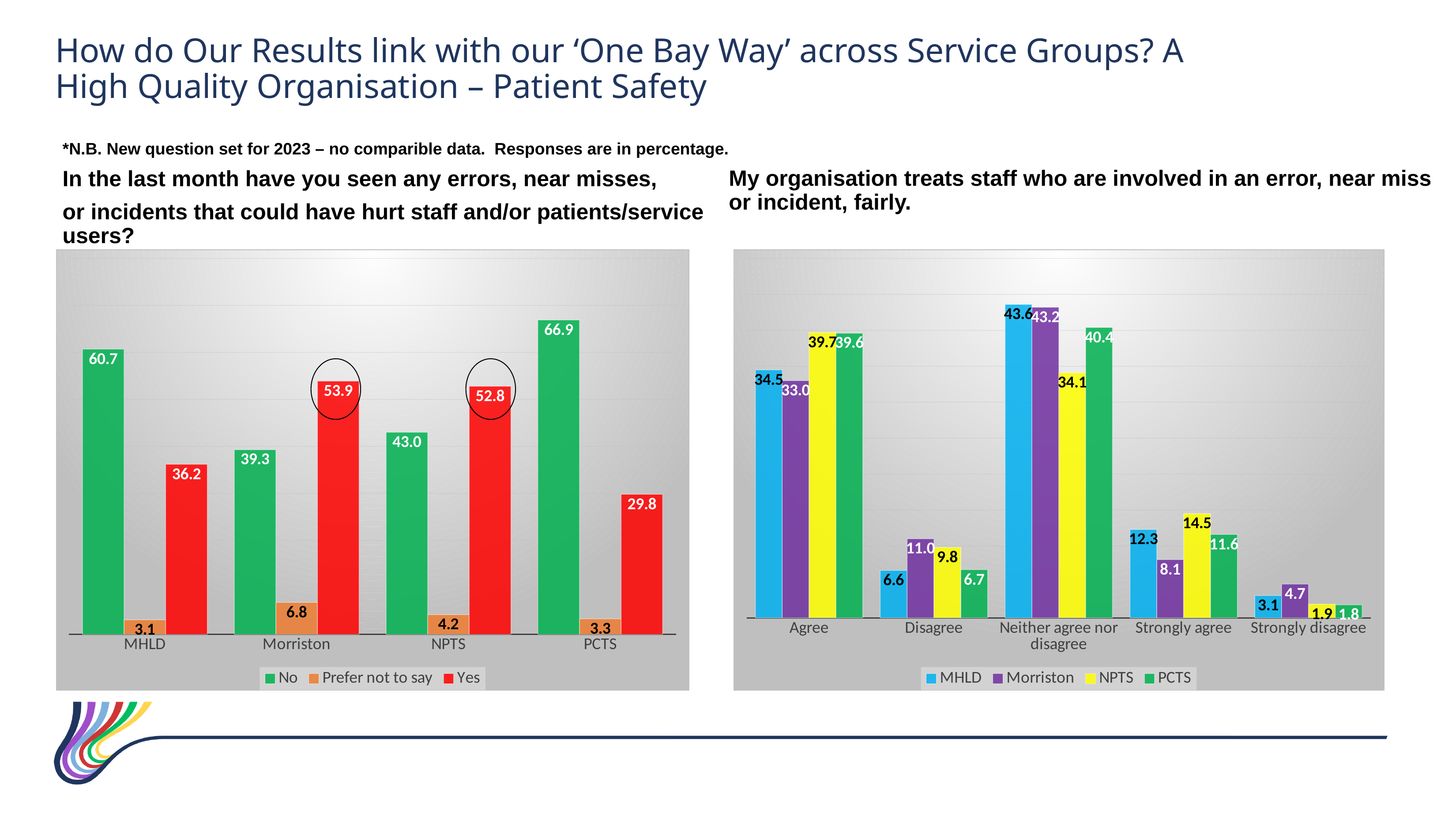
In the left chart (errors, near misses or incidents seen in the last month), what is the 'No' value for PCTS? 66.9 In the right chart (organisation treats staff involved in an error fairly), what is the MHLD value for 'Neither agree nor disagree'? 43.6 In the right chart (organisation treats staff involved in an error fairly), what is the NPTS value for 'Strongly agree'? 14.5 What type of chart is the right chart (organisation treats staff involved in an error fairly)? bar chart In the right chart (organisation treats staff involved in an error fairly), which service group has the highest 'Disagree' value? Morriston In the left chart (errors, near misses or incidents seen in the last month), what is the difference between the 'No' values for PCTS and NPTS? 23.9 In the right chart (organisation treats staff involved in an error fairly), how many response categories are shown on the x axis? 5 In the left chart (errors, near misses or incidents seen in the last month), which service group has the highest 'Yes' value? Morriston In the left chart (errors, near misses or incidents seen in the last month), what is the 'Yes' value for Morriston? 53.9 In the right chart (organisation treats staff involved in an error fairly), is the Morriston 'Agree' value larger or smaller than the PCTS 'Agree' value? smaller In the left chart (errors, near misses or incidents seen in the last month), how many series does the legend list? 3 In the left chart (errors, near misses or incidents seen in the last month), which service group has the lowest 'Prefer not to say' value? MHLD